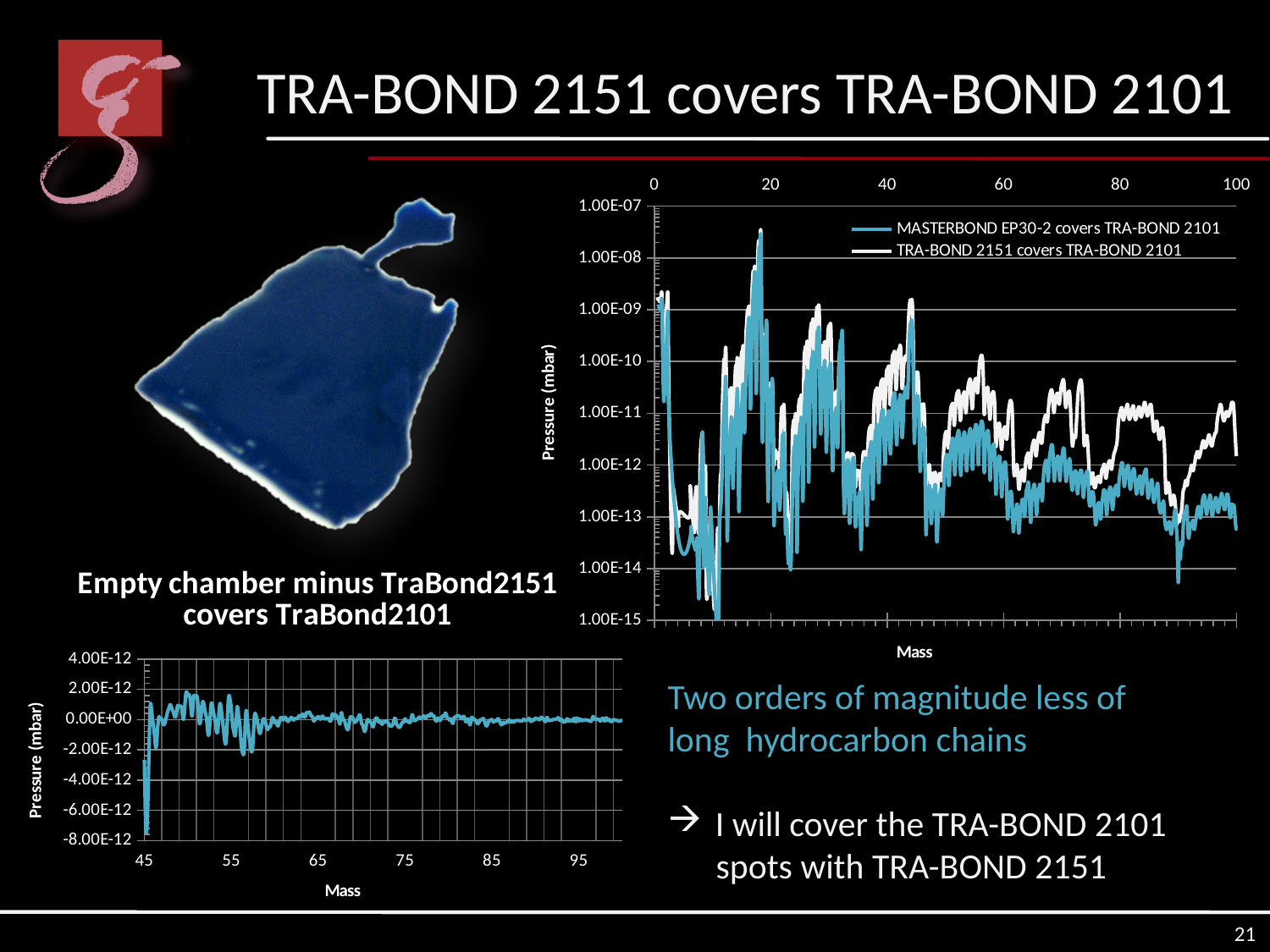
In the top-right chart, is the highest peak near mass 20 greater or less than 1.00E-08 mbar? greater In the bottom-left chart, is the lowest value near mass 45 greater or less than -6.00E-12? less What is the title of the bottom-left chart? Empty chamber minus TraBond2151 covers TraBond2101 How many labelled tick marks are on the x-axis of the bottom-left chart? 6 In the bottom-left chart, is the value at mass 85 greater or less than 2.00E-12? less In the top-right chart, around mass 90, which series shows the higher pressure? TRA-BOND 2151 covers TRA-BOND 2101 What are the two series named in the legend of the top-right chart? MASTERBOND EP30-2 covers TRA-BOND 2101; TRA-BOND 2151 covers TRA-BOND 2101 What kind of chart is the top-right chart with the Mass x-axis from 0 to 100? line chart How many series does the legend of the top-right chart list? 2 What kind of chart is the bottom-left chart? line chart